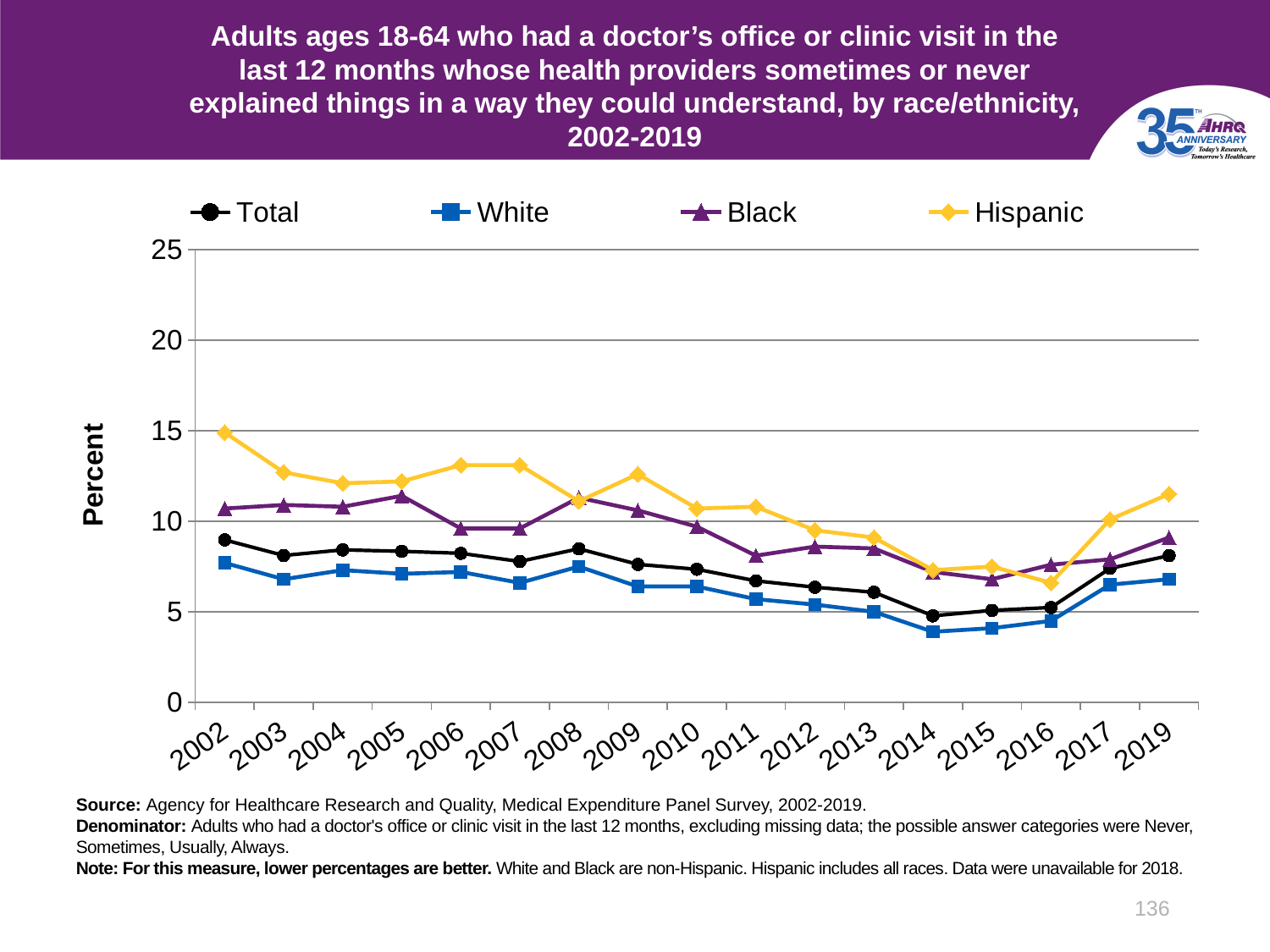
What kind of chart is shown on the slide? Line chart Which series has the highest value in 2002? Hispanic Is the value for Black in 2005 greater or less than 10? greater Does the White series generally rise or fall from 2002 to 2014? Fall Is the value for Hispanic in 2002 greater or less than 10? greater Is the value for White in 2014 greater or less than 5? less How many years are plotted along the x axis? 17 Which series has the lowest value in 2014? White How many series does the legend list? 4 What is the label on the y axis? Percent Which is larger in 2019, the value for Black or the value for Total? Black